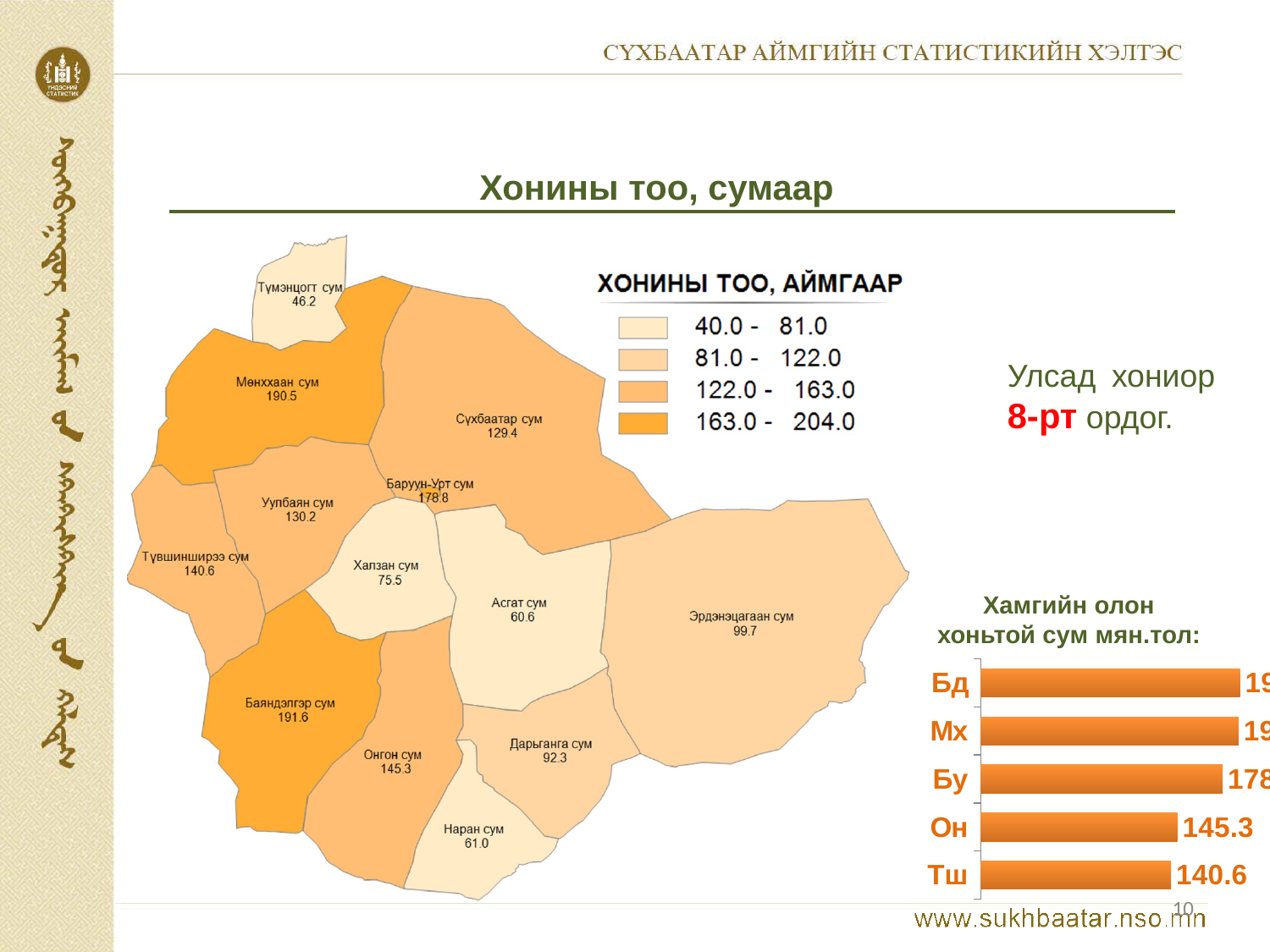
On the map, what is the value shown for Сүхбаатар сум? 129.4 On the map, which sum has the lowest value? Түмэнцогт сум In the bar chart at the bottom right, which category has the lowest value? Тш In the bar chart at the bottom right, what is the value for Тш? 140.6 What kind of chart is shown at the bottom right of the slide? Bar chart On the map, what is the value shown for Эрдэнэцагаан сум? 99.7 In the bar chart at the bottom right, what is the difference between the values for Он and Тш? 4.7 What is the title of the bar chart at the bottom right? Хамгийн олон хоньтой сум мян.тол: In the bar chart at the bottom right, what is the value for Он? 145.3 How many categories does the bar chart at the bottom right show? 5 How many value ranges does the map legend list? 4 In the bar chart at the bottom right, which is larger, the value for Он or the value for Тш? Он